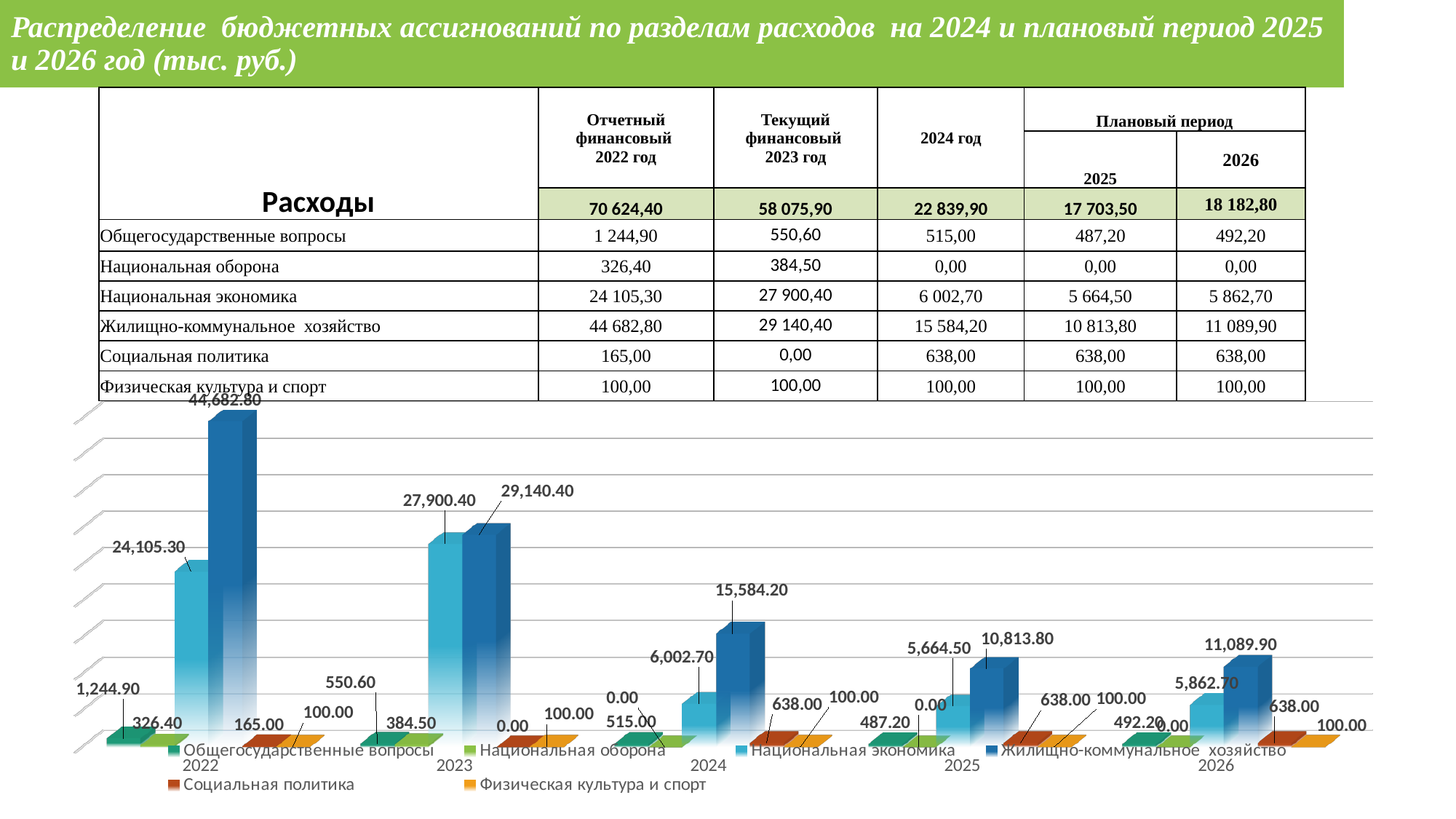
What is the value for Социальная политика in 2024 on the chart? 638.00 What is the difference between the Жилищно-коммунальное хозяйство values for 2026 and 2025? 276.10 What is the value for Жилищно-коммунальное хозяйство in 2022 on the chart? 44,682.80 How many year categories are shown on the chart's x axis? 5 How many series does the chart legend list? 6 What type of chart is shown on the slide? bar chart In which year is the Национальная экономика bar the lowest? 2025 Which is larger in 2023: Национальная экономика or Жилищно-коммунальное хозяйство? Жилищно-коммунальное хозяйство Does the Жилищно-коммунальное хозяйство value rise or fall from 2022 to 2025? fall Which series is shown in orange in the chart legend? Физическая культура и спорт In which year is the Жилищно-коммунальное хозяйство bar the highest? 2022 What is the value for Национальная экономика in 2023 on the chart? 27,900.40